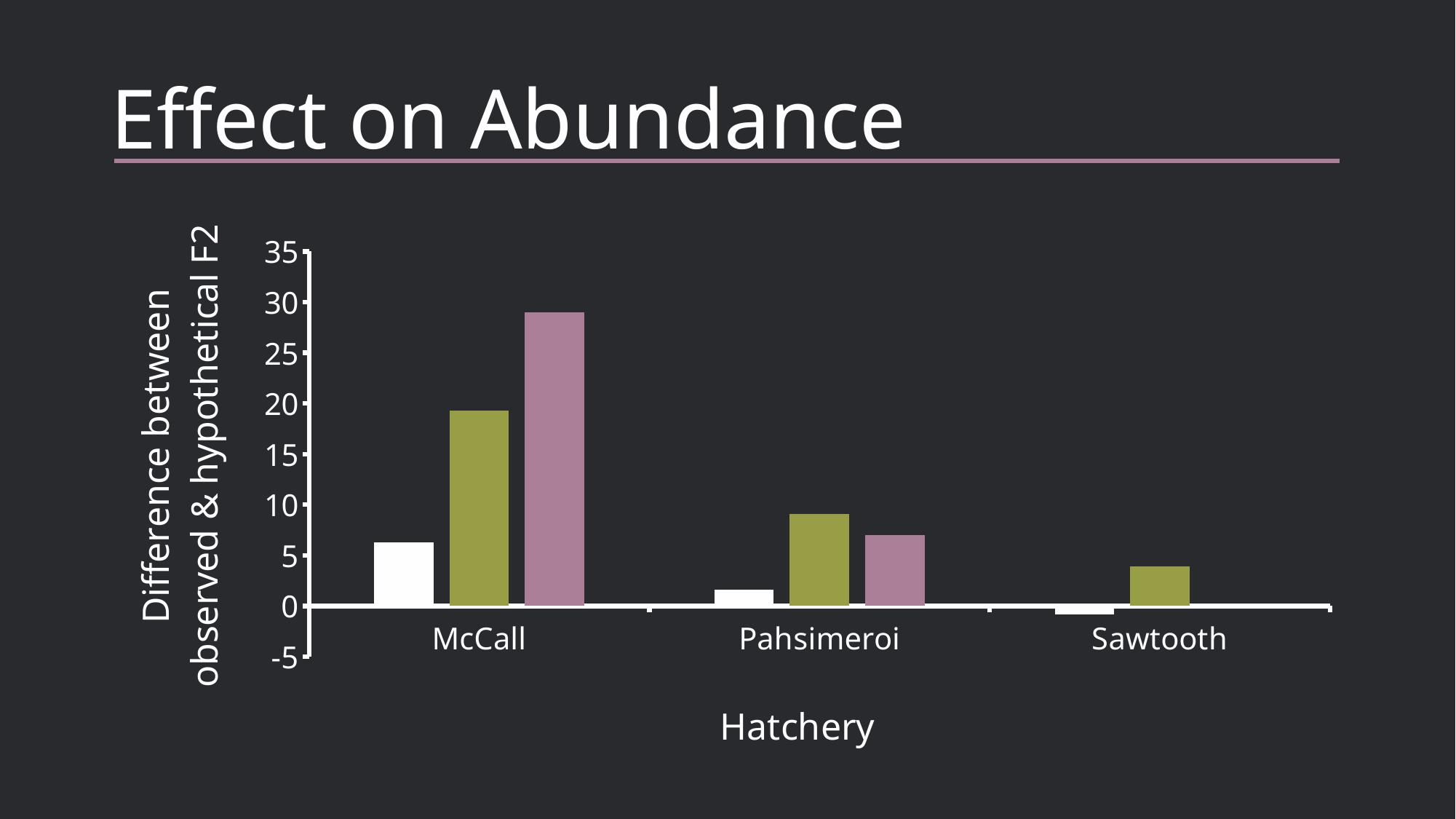
Which is larger, the olive-green bar for McCall or the olive-green bar for Pahsimeroi? McCall What is the title of the x axis? Hatchery Is the value of the white bar for Pahsimeroi greater or less than 5? less Is the value of the olive-green bar for McCall greater or less than 15? greater What is the title of the y axis? Difference between observed & hypothetical F2 Is the value of the pink bar for Pahsimeroi greater or less than 5? greater How many hatcheries are shown on the x axis? 3 For Pahsimeroi, which is larger, the olive-green bar or the pink bar? the olive-green bar Which hatchery has the lowest olive-green bar? Sawtooth What kind of chart is shown on the slide? bar chart Which hatchery has the tallest bar in the chart? McCall